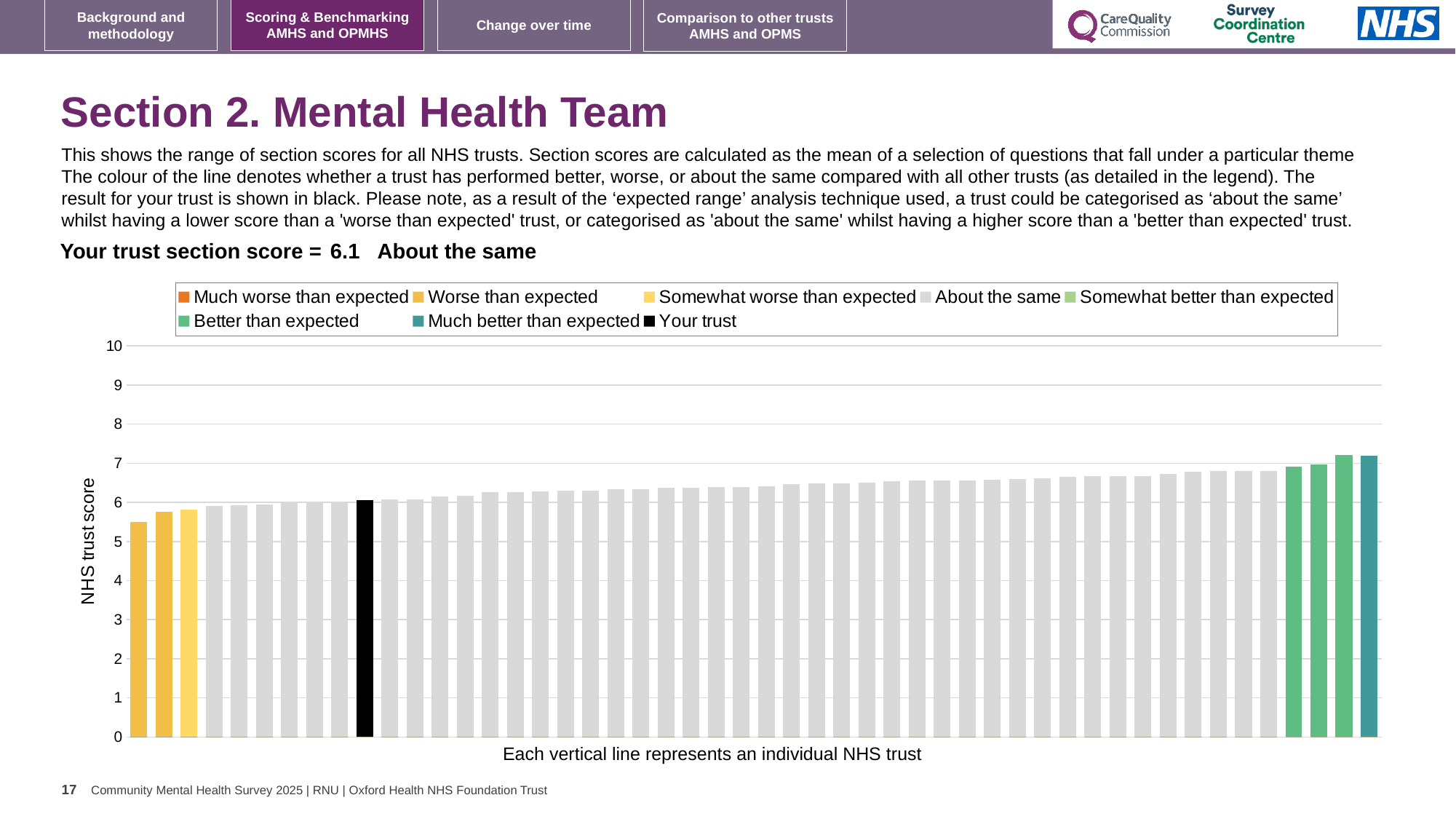
How many entries does the chart legend list? 8 Which category does your trust fall into according to the slide? About the same Is the value of the highest bar in the chart greater or less than 7? greater What is the label on the y axis of the chart? NHS trust score What is the section score for your trust shown on the slide? 6.1 Is the value for your trust (the black bar) greater or less than 7? less Do the bar values rise or fall from left to right along the x axis? rise What colour does the legend use for 'Your trust'? black Which is larger: the value for your trust (black bar) or the value of the leftmost bar? your trust What kind of chart is shown on the slide? bar chart Is the value of the leftmost bar greater or less than 6? less